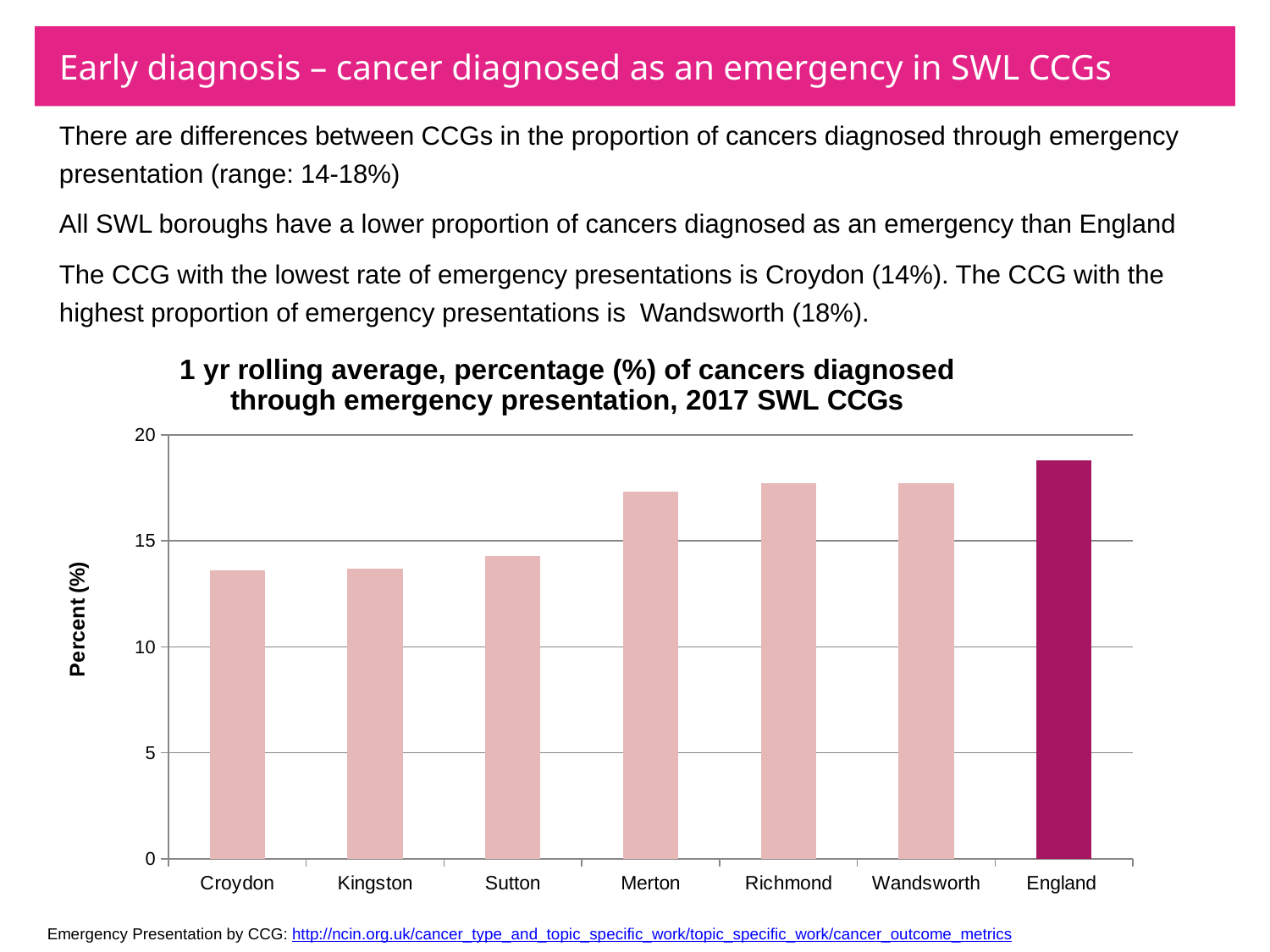
Is the value for Croydon greater or less than 15? less Which has a larger value, Croydon or England? England Is the value for England greater or less than 20? less Is the value for Sutton greater or less than 15? less How many categories are shown on the x axis of the chart? 7 What is the label on the y axis of the chart? Percent (%) Do the bar values generally rise or fall moving from left to right along the x axis? rise What type of chart is shown on the slide? bar chart Which category has the highest bar in the chart? England Which has a larger value, Merton or Sutton? Merton